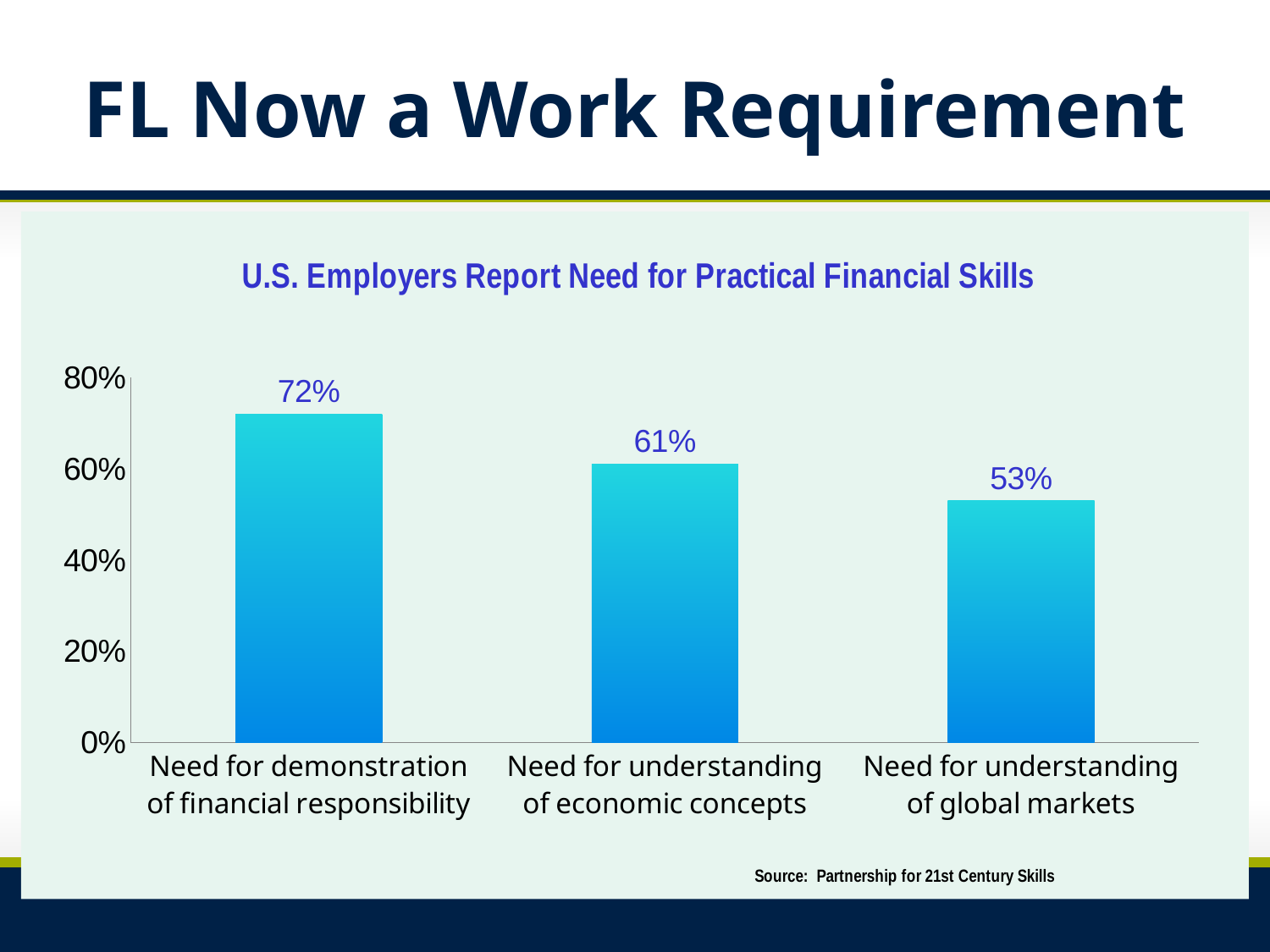
Which is larger: the value for 'Need for understanding of economic concepts' or 'Need for understanding of global markets'? Need for understanding of economic concepts How many categories are shown in the chart? 3 What is the value for 'Need for demonstration of financial responsibility'? 72% Is the value for 'Need for understanding of global markets' greater or less than 60%? less What is the difference between the values for 'Need for demonstration of financial responsibility' and 'Need for understanding of global markets'? 19% Which category has the highest value? Need for demonstration of financial responsibility What is the value for 'Need for understanding of global markets'? 53% What is the value for 'Need for understanding of economic concepts'? 61% What is the title of the chart? U.S. Employers Report Need for Practical Financial Skills Which category has the lowest value? Need for understanding of global markets What kind of chart is shown on the slide? bar chart What is the difference between the values for 'Need for understanding of economic concepts' and 'Need for understanding of global markets'? 8%